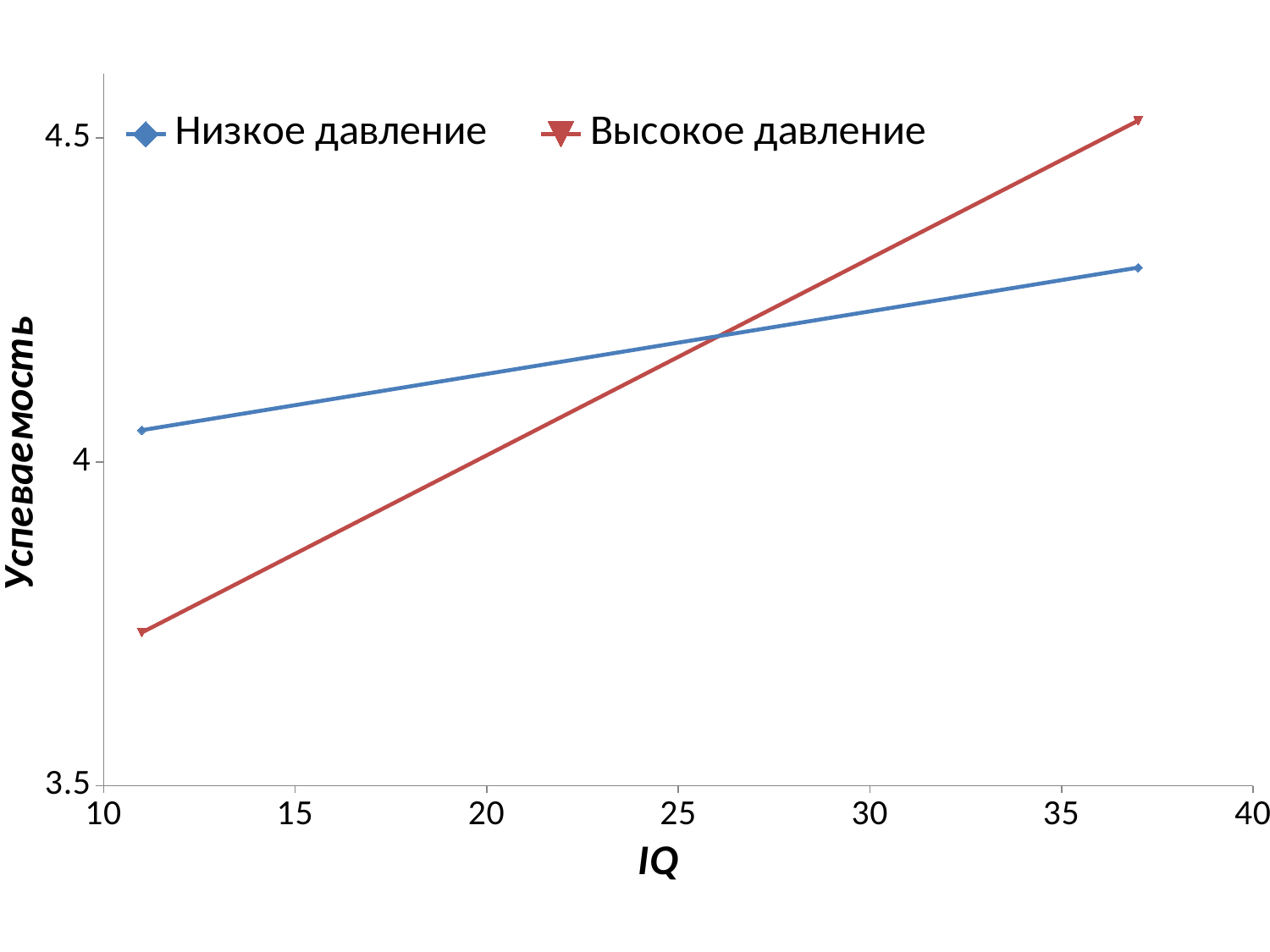
How many data points does each series have? 2 Is the Успеваемость value for Низкое давление at the highest IQ greater or less than 4.5? less Does the Высокое давление line rise or fall as IQ increases? rises Does the Низкое давление line rise or fall as IQ increases? rises Is the Успеваемость value for Низкое давление at the highest IQ greater or less than 4? greater At the right end of the chart (highest IQ), which series has the higher Успеваемость value: Низкое давление or Высокое давление? Высокое давление What is the title of the x axis? IQ How many series does the legend list? 2 What are the two series named in the legend? Низкое давление and Высокое давление At the left end of the chart (lowest IQ), which series has the higher Успеваемость value: Низкое давление or Высокое давление? Низкое давление Is the Успеваемость value for Высокое давление at the lowest IQ greater or less than 4? less What kind of chart is shown on the slide? line chart